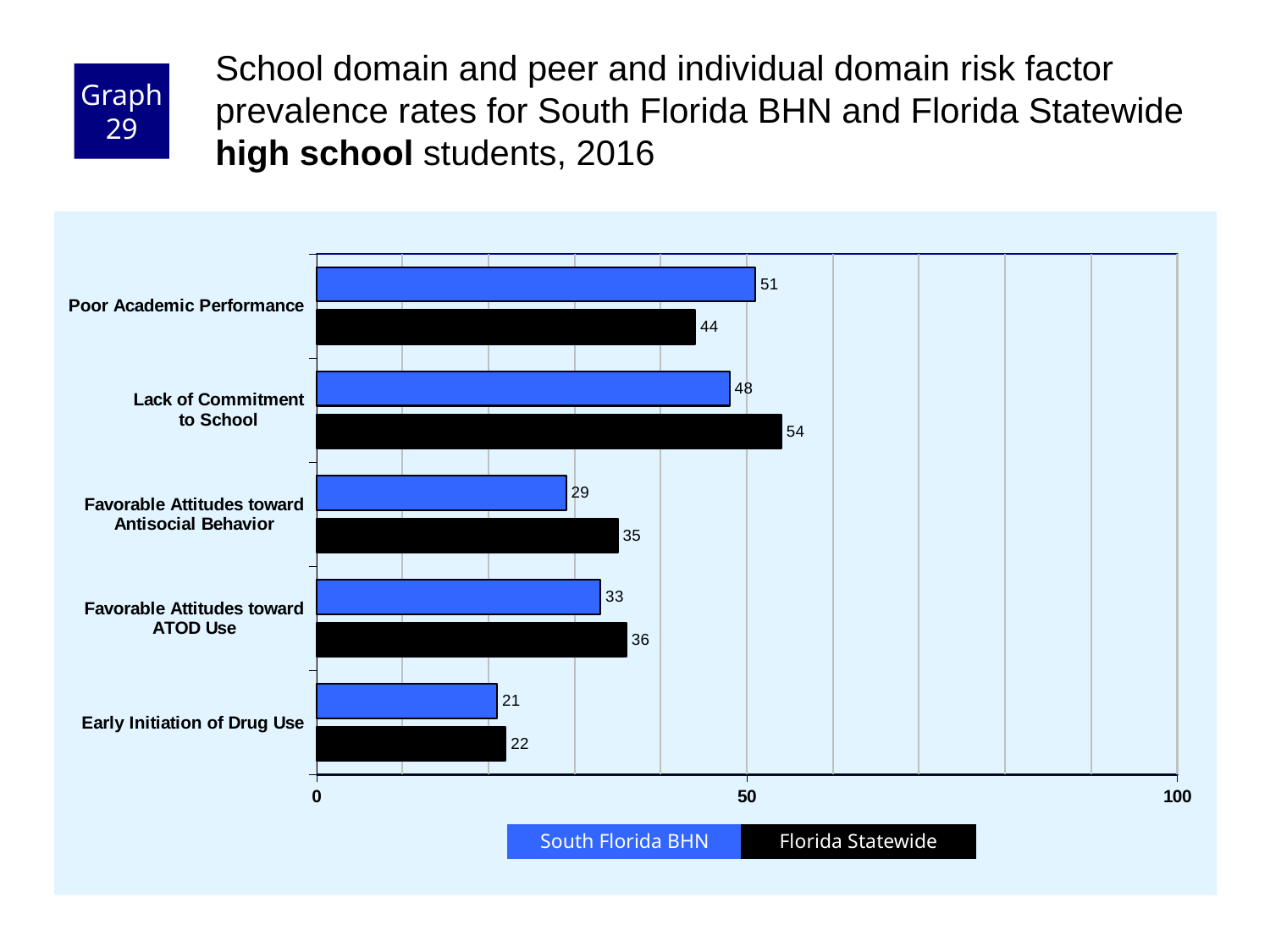
What is the South Florida BHN value for Early Initiation of Drug Use? 21 What colour are the Florida Statewide bars? black How many risk factor categories are shown in the chart? 5 How many series does the legend list? 2 For Poor Academic Performance, which is larger: South Florida BHN or Florida Statewide? South Florida BHN Which risk factor has the highest Florida Statewide value? Lack of Commitment to School Which risk factor has the lowest South Florida BHN value? Early Initiation of Drug Use What is the difference between the Florida Statewide and South Florida BHN values for Favorable Attitudes toward Antisocial Behavior? 6 Is the Florida Statewide value for Favorable Attitudes toward ATOD Use greater or less than 50? less What kind of chart is shown on the slide? bar chart What is the Florida Statewide value for Lack of Commitment to School? 54 What is the South Florida BHN value for Poor Academic Performance? 51